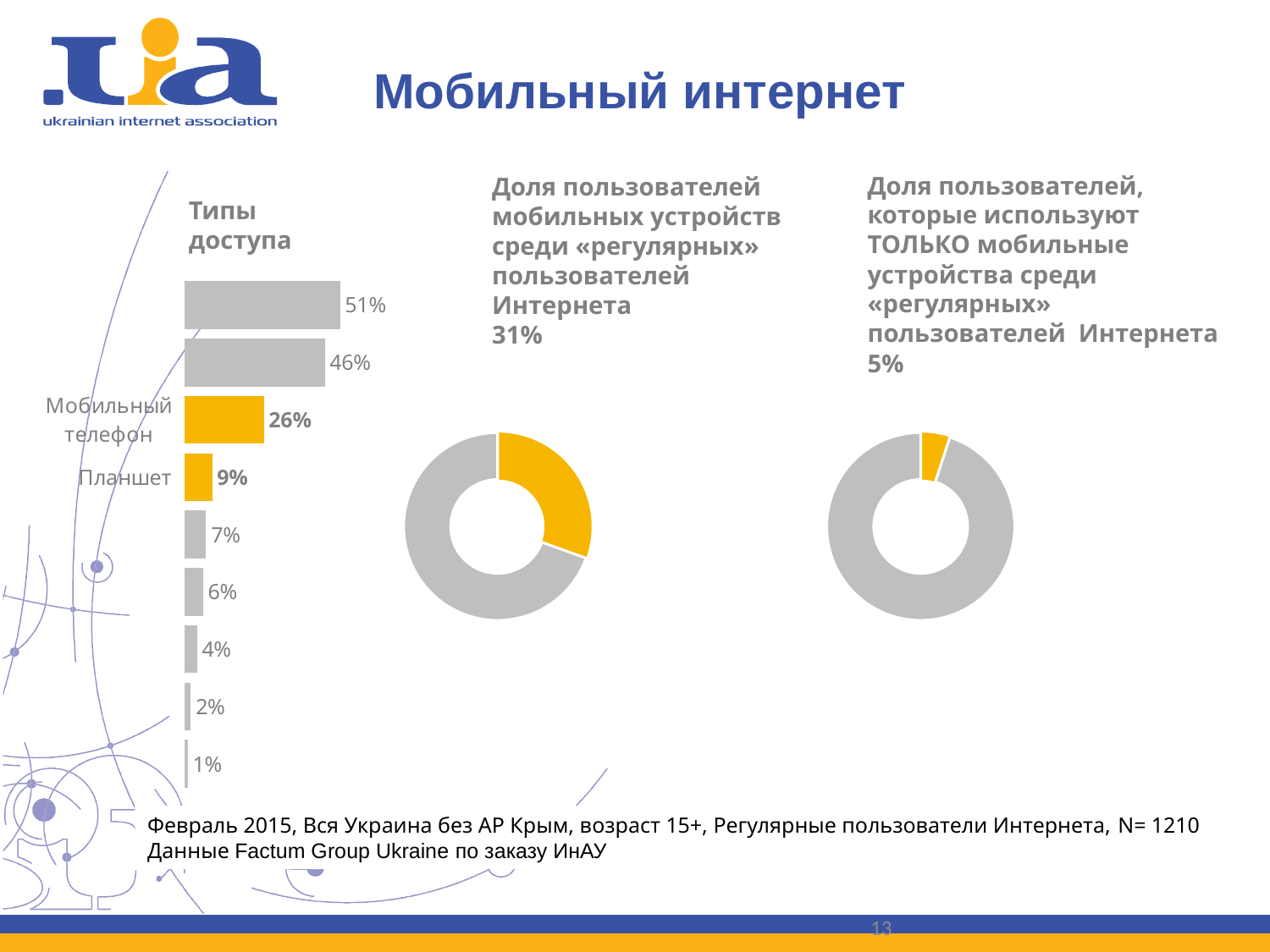
What kind of chart shows the share of mobile device users among regular Internet users (the middle chart)? Donut chart In the 'Типы доступа' bar chart, which is larger: Мобильный телефон or Планшет? Мобильный телефон What share of regular Internet users use mobile devices, according to the middle donut chart? 31% In the 'Типы доступа' bar chart, what is the value for Планшет? 9% How many bars are in the 'Типы доступа' bar chart? 9 What share of regular Internet users use ONLY mobile devices, according to the right donut chart? 5% In the 'Типы доступа' bar chart, what colour are the bars for Мобильный телефон and Планшет? Yellow In the 'Типы доступа' bar chart, what is the value of the longest bar? 51% In the 'Типы доступа' bar chart, what is the value for Мобильный телефон? 26% In the 'Типы доступа' bar chart, what is the value of the shortest bar? 1% In the 'Типы доступа' bar chart, what is the difference between the values for Мобильный телефон and Планшет? 17% What kind of chart is the 'Типы доступа' chart? Bar chart